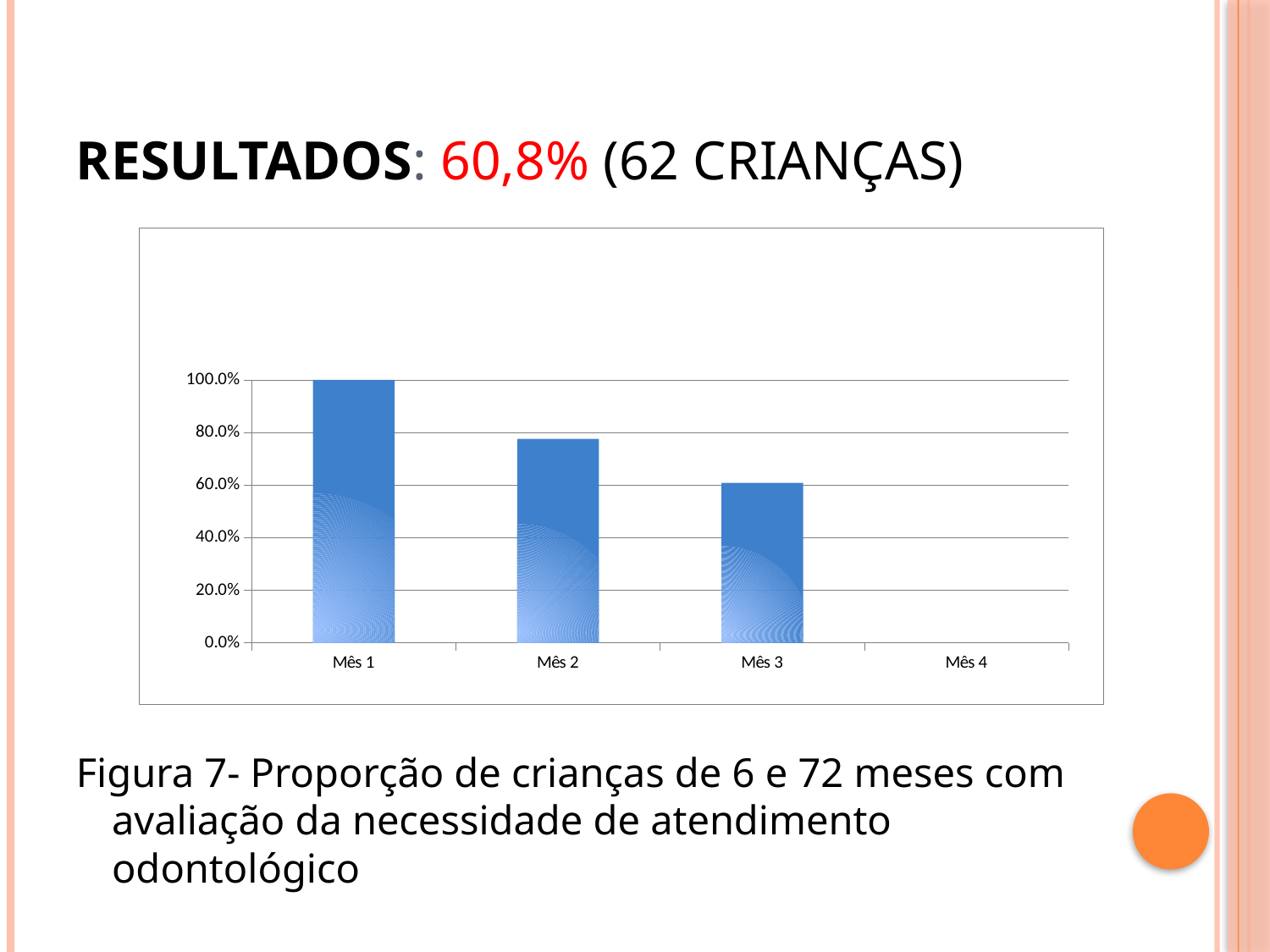
Is the value for Mês 2 greater or less than 80.0%? less Is the value for Mês 3 greater or less than 80.0%? less What is the value for Mês 1 in the chart? 100.0% Is the value for Mês 2 greater or less than 60.0%? greater What kind of chart is shown on the slide? bar chart Among Mês 1, Mês 2 and Mês 3, which has the lowest bar? Mês 3 Which is larger, the value for Mês 1 or the value for Mês 2? Mês 1 Do the bar values rise or fall from Mês 1 to Mês 3? fall Which month has the highest bar in the chart? Mês 1 What is the highest value labelled on the y axis of the chart? 100.0% How many categories are shown on the x axis of the chart? 4